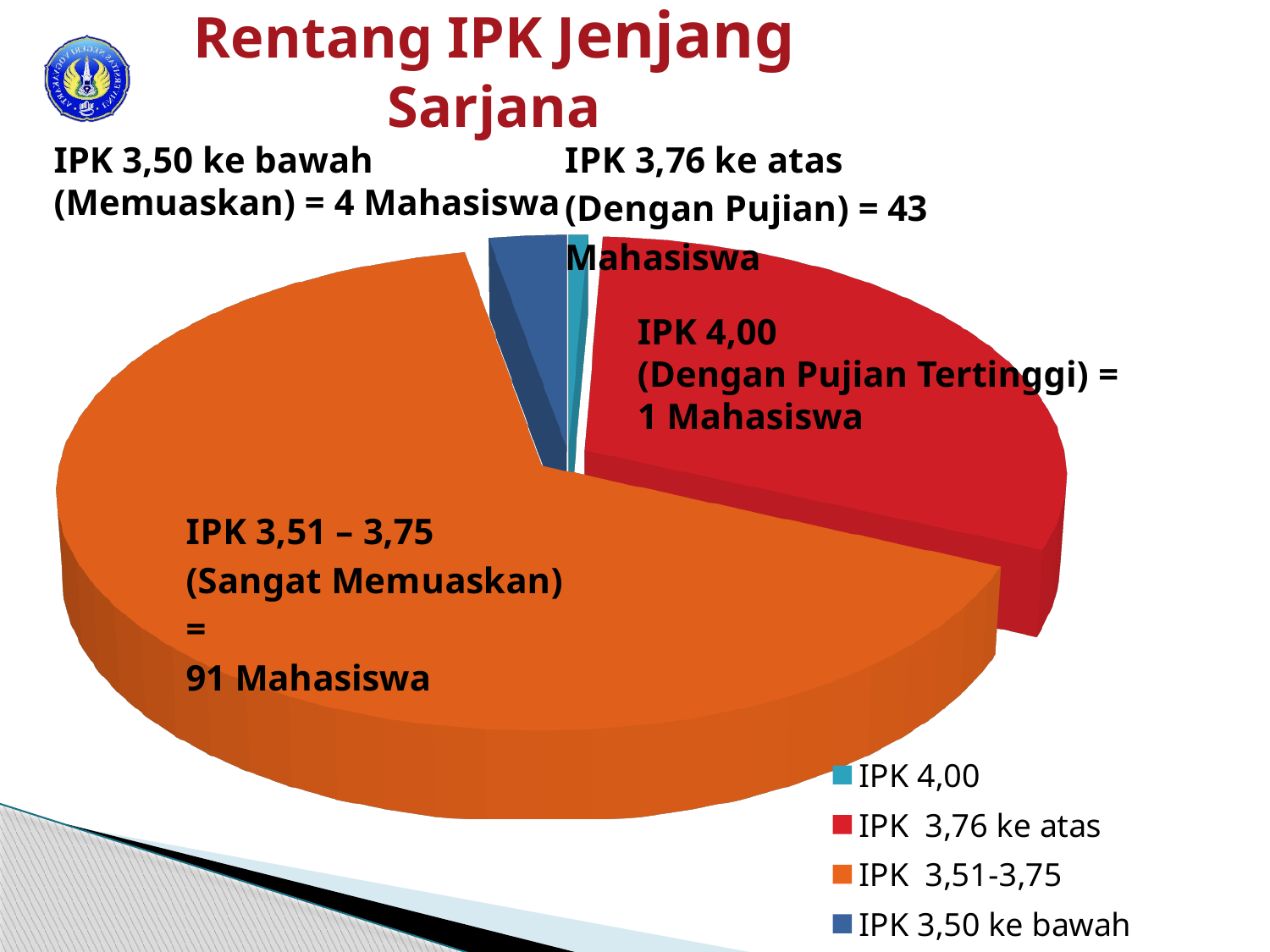
How many students have an IPK of 3,50 ke bawah (Memuaskan)? 4 Mahasiswa What is the total number of students represented in the pie chart? 139 Which IPK range has the largest number of students? IPK 3,51-3,75 How many students have an IPK of 4,00 (Dengan Pujian Tertinggi)? 1 Mahasiswa What colour is the slice for IPK 3,76 ke atas? Red How many students have an IPK of 3,76 ke atas (Dengan Pujian)? 43 Mahasiswa Which IPK range has the smallest number of students? IPK 4,00 What kind of chart is shown on the slide? Pie chart How many students have an IPK of 3,51 – 3,75 (Sangat Memuaskan)? 91 Mahasiswa Which group has more students: IPK 3,50 ke bawah or IPK 4,00? IPK 3,50 ke bawah How many slices does the pie chart have? 4 What is the difference between the number of students with IPK 3,51-3,75 and those with IPK 3,76 ke atas? 48